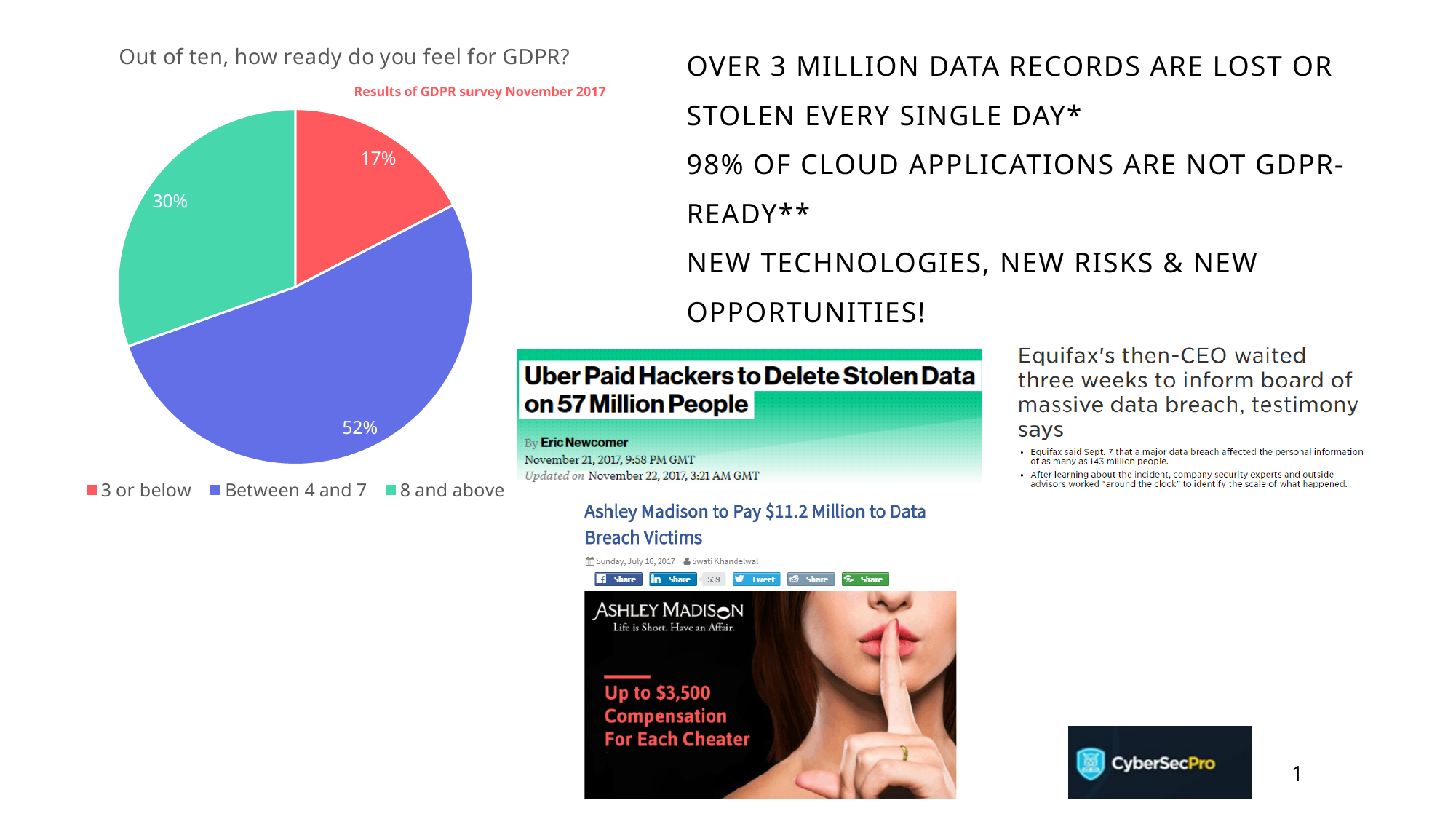
Which category has the largest share of the pie? Between 4 and 7 What colour is the 'Between 4 and 7' slice of the pie chart? Blue Which category has the smallest share of the pie? 3 or below What percentage of respondents rated their GDPR readiness as 3 or below? 17% What is the difference in percentage points between the 'Between 4 and 7' slice and the '8 and above' slice? 22 What kind of chart is shown on the slide? Pie chart What percentage of respondents rated their GDPR readiness between 4 and 7? 52% Which is larger: the share for '8 and above' or the share for '3 or below'? 8 and above What percentage of respondents rated their GDPR readiness as 8 and above? 30% What is the difference in percentage points between the '8 and above' slice and the '3 or below' slice? 13 How many categories does the pie chart show? 3 What is the title of the pie chart? Out of ten, how ready do you feel for GDPR?